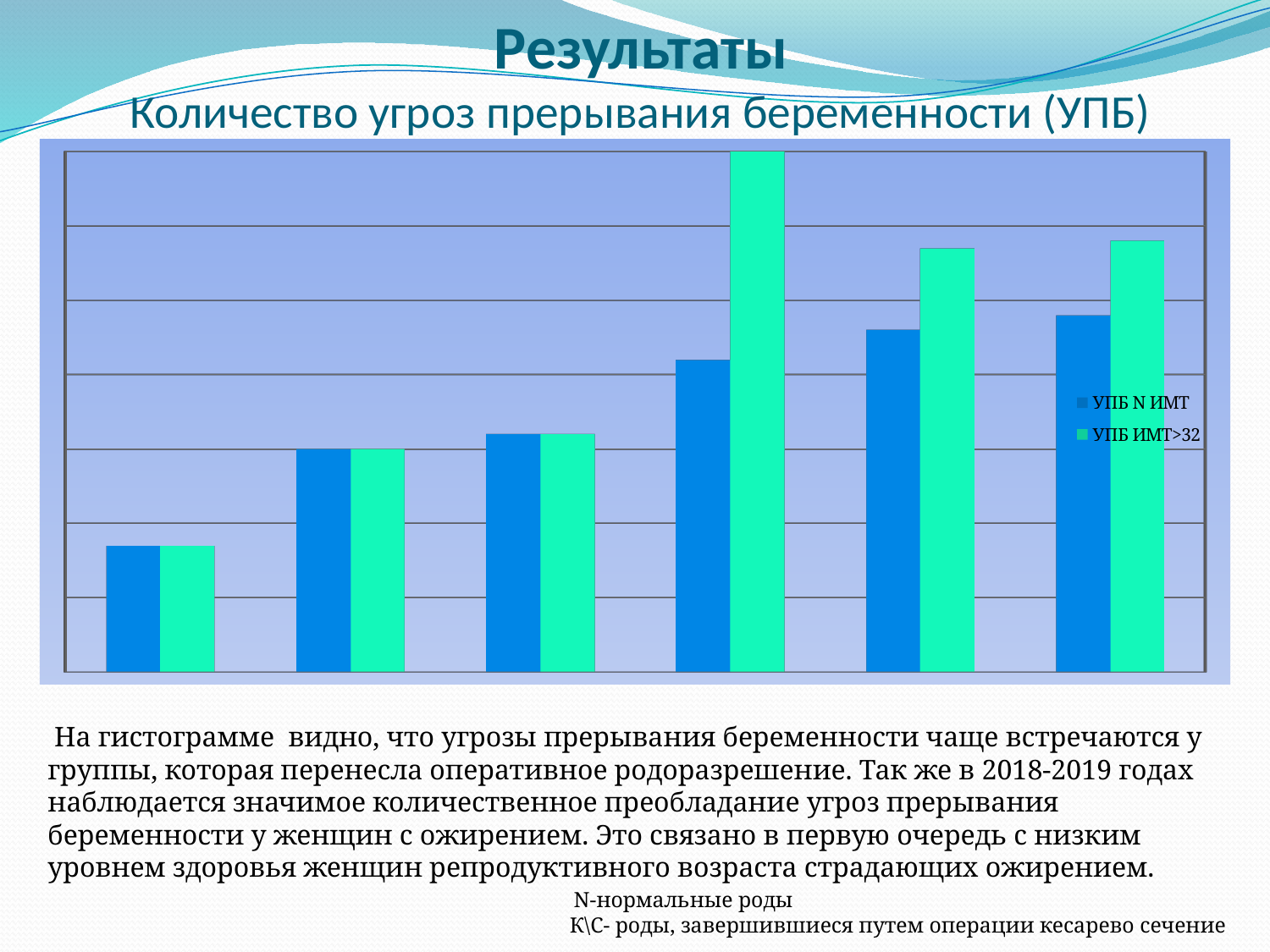
What kind of chart is shown on the slide? bar chart In the fifth group of bars from the left, which series has the larger value? УПБ ИМТ>32 Which group of bars, counted from the left, has the tallest "УПБ ИМТ>32" bar? the fourth group Which group of bars, counted from the left, has the lowest values for both series? the first (leftmost) group How many groups of bars are plotted in the chart? 6 Do the values of the "УПБ ИМТ>32" series generally rise or fall from left to right across the chart? rise How many series does the legend of the chart list? 2 What are the two series named in the chart legend? УПБ N ИМТ and УПБ ИМТ>32 What is the title of the chart on the slide? Количество угроз прерывания беременности (УПБ) In the fourth group of bars from the left, which series has the larger value? УПБ ИМТ>32 Do the values of the "УПБ N ИМТ" series generally rise or fall from left to right across the chart? rise In the rightmost group of bars, which series has the larger value? УПБ ИМТ>32